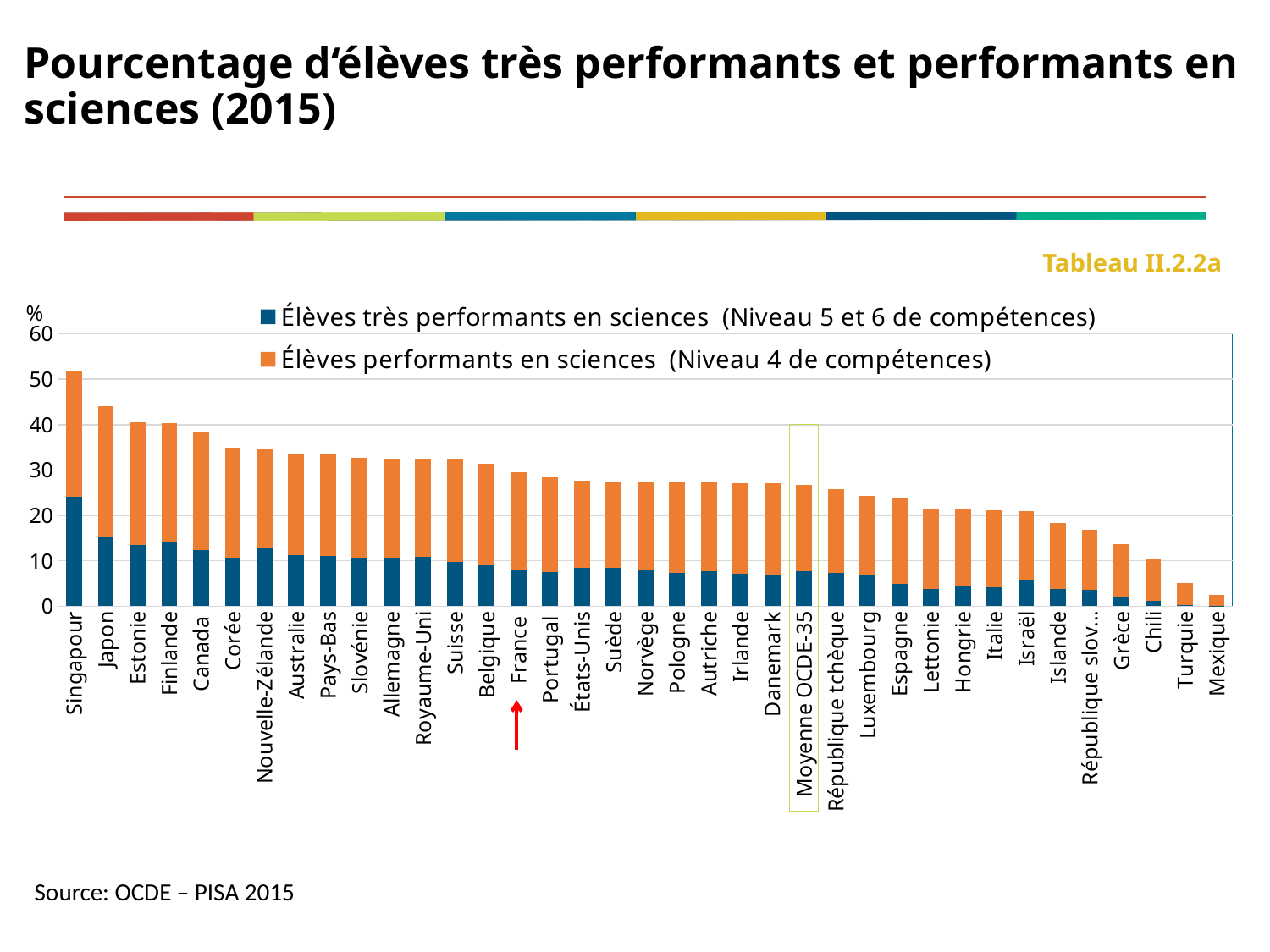
Do the total bar values rise or fall from left to right along the x axis? fall What kind of chart is shown on the slide? stacked bar chart How many countries or categories are shown along the x axis? 37 How many series does the legend list? 2 Which category has the highest total bar? Singapour Is the total bar for Mexique greater or less than 10? less Is the 'Élèves très performants en sciences' value for France greater or less than 10? less Is the total bar for Singapour greater or less than 50? greater Which category has the lowest total bar? Mexique Which has a larger total bar, Japon or Estonie? Japon Which category has the largest share of 'Élèves très performants en sciences (Niveau 5 et 6 de compétences)'? Singapour